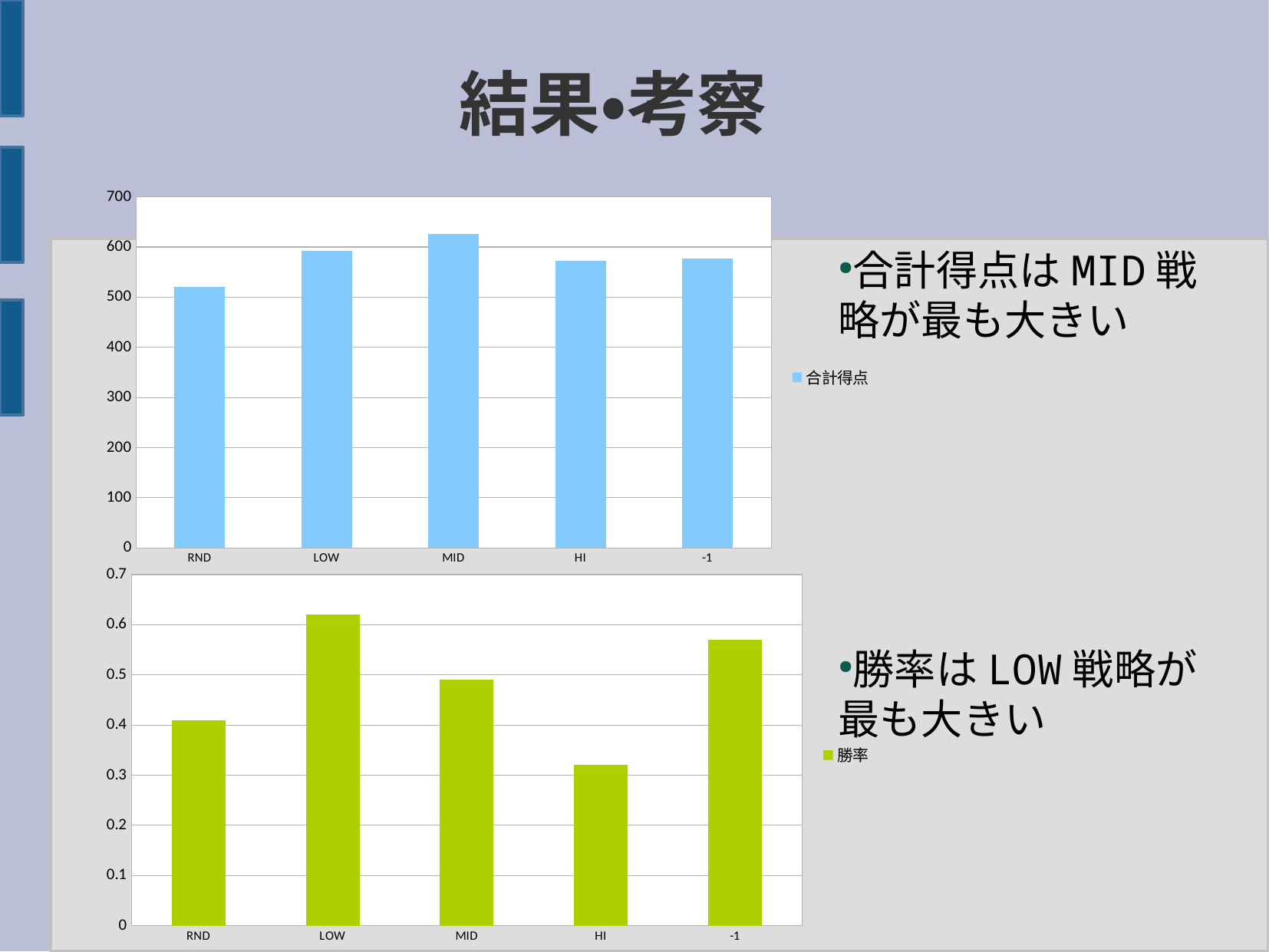
In the bottom chart (勝率), which category has the lowest value? HI In the top chart (合計得点), which category has the lowest value? RND What series name does the legend of the top chart show? 合計得点 In the top chart (合計得点), is the value for RND greater or less than 600? less In the top chart (合計得点), which category has the highest value? MID In the bottom chart (勝率), is the value for HI greater or less than 0.4? less In the bottom chart (勝率), which is larger, the value for LOW or the value for HI? LOW What type of chart is the bottom chart (勝率)? bar chart In the bottom chart (勝率), is the value for -1 greater or less than 0.5? greater In the bottom chart (勝率), which category has the highest value? LOW How many categories are shown on the x axis of the top chart (合計得点)? 5